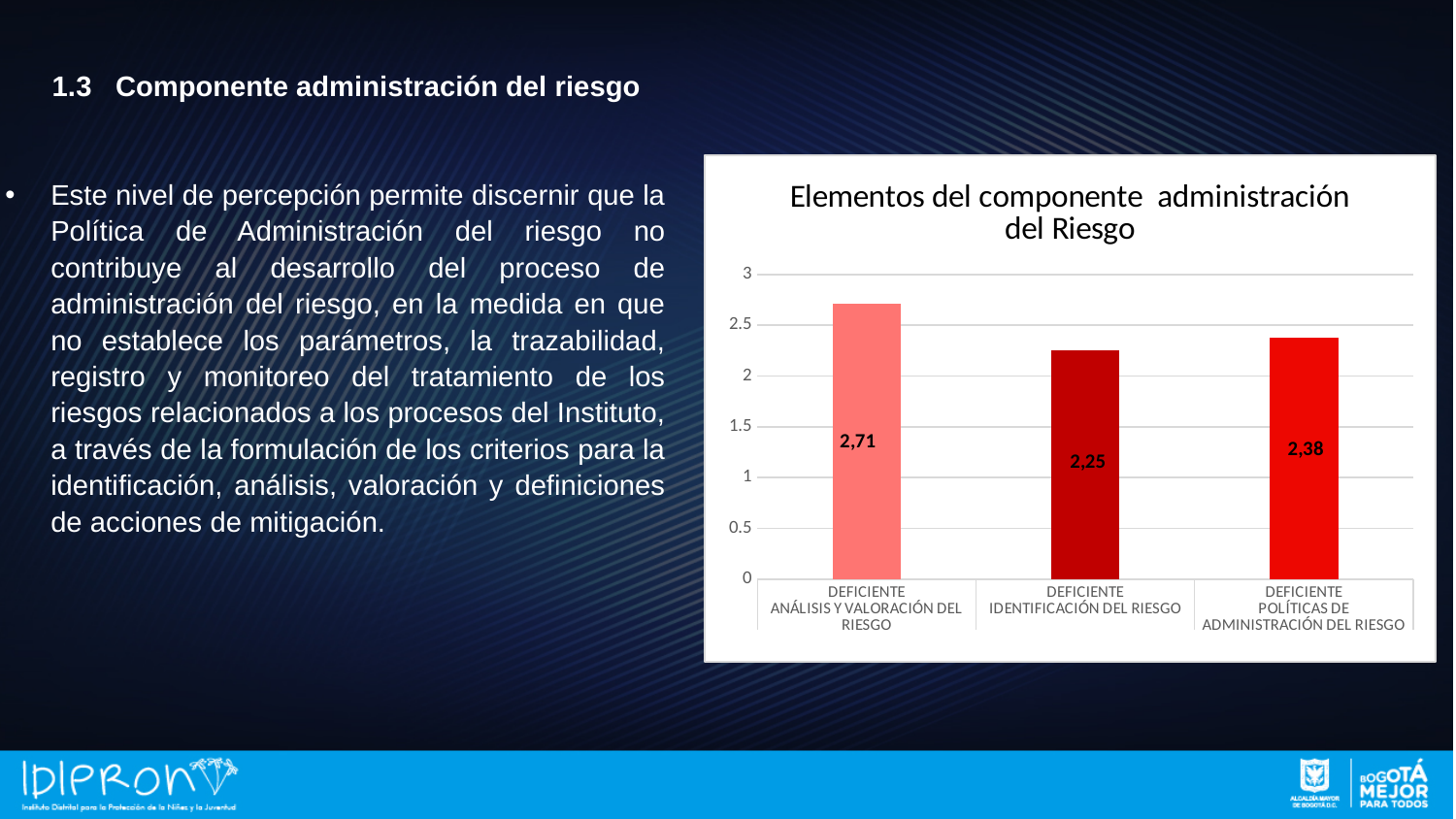
How many categories are shown in the chart? 3 What is the value for DEFICIENTE POLÍTICAS DE ADMINISTRACIÓN DEL RIESGO? 2,38 What is the difference between the values for DEFICIENTE POLÍTICAS DE ADMINISTRACIÓN DEL RIESGO and DEFICIENTE IDENTIFICACIÓN DEL RIESGO? 0,13 Which is larger, the value for DEFICIENTE POLÍTICAS DE ADMINISTRACIÓN DEL RIESGO or the value for DEFICIENTE IDENTIFICACIÓN DEL RIESGO? DEFICIENTE POLÍTICAS DE ADMINISTRACIÓN DEL RIESGO What is the value for DEFICIENTE IDENTIFICACIÓN DEL RIESGO? 2,25 Which category has the lowest value? DEFICIENTE IDENTIFICACIÓN DEL RIESGO What kind of chart is shown on the slide? bar chart Which category has the highest value? DEFICIENTE ANÁLISIS Y VALORACIÓN DEL RIESGO What is the value for DEFICIENTE ANÁLISIS Y VALORACIÓN DEL RIESGO? 2,71 What is the difference between the values for DEFICIENTE ANÁLISIS Y VALORACIÓN DEL RIESGO and DEFICIENTE IDENTIFICACIÓN DEL RIESGO? 0,46 Is the value for DEFICIENTE ANÁLISIS Y VALORACIÓN DEL RIESGO greater or less than 2.5? greater What is the title of the chart? Elementos del componente administración del Riesgo